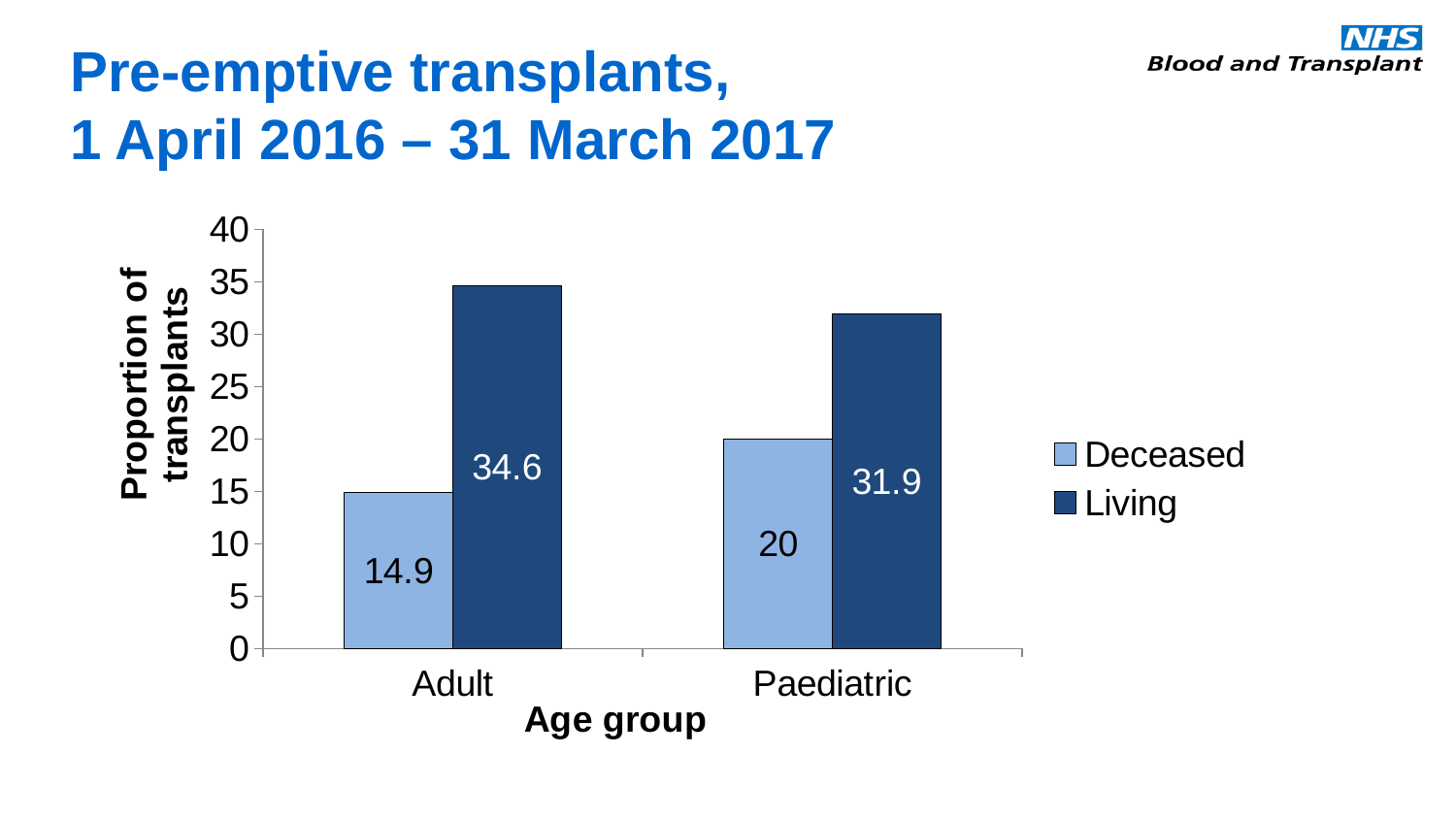
Which bar shows the lowest value on the chart? Adult, Deceased What is the value for Deceased in the Paediatric age group? 20 How many age groups are shown on the x axis? 2 What is the difference between the Deceased values for Paediatric and Adult? 5.1 What is the label of the y axis? Proportion of transplants What kind of chart is shown on the slide? Bar chart Is the Living value for the Adult age group greater or less than 30? greater How many series does the legend list? 2 Which age group has the higher value for Living donors? Adult What is the difference between the Living and Deceased values for the Adult age group? 19.7 What is the proportion of pre-emptive transplants from deceased donors for the Adult age group? 14.9 What is the proportion of pre-emptive transplants from living donors for the Paediatric age group? 31.9